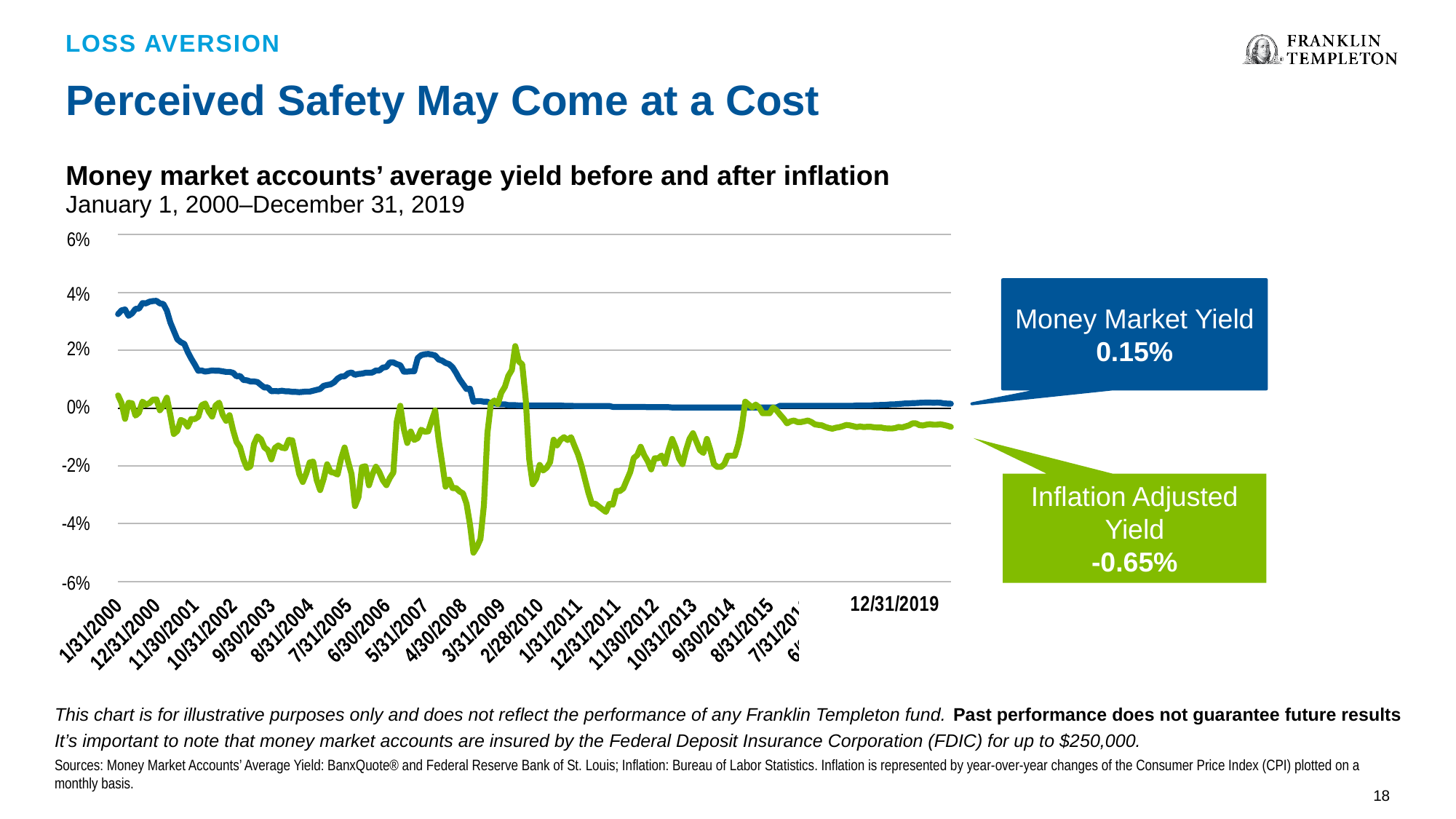
What is the title of the chart? Money market accounts' average yield before and after inflation What is the Money Market Yield at 12/31/2019? 0.15% Is the lowest point of the Inflation Adjusted Yield line greater or less than -4%? less How many series are plotted on the chart? 2 At 12/31/2019, which is higher: the Money Market Yield or the Inflation Adjusted Yield? Money Market Yield Is the Money Market Yield at 1/31/2000 greater or less than 2%? greater What kind of chart is shown on the slide? line chart What is the difference between the Money Market Yield (0.15%) and the Inflation Adjusted Yield (-0.65%) at 12/31/2019? 0.80% What is the Inflation Adjusted Yield at 12/31/2019? -0.65% What is the highest value shown on the vertical axis? 6% Does the Money Market Yield rise or fall overall from 1/31/2000 to 12/31/2019? fall